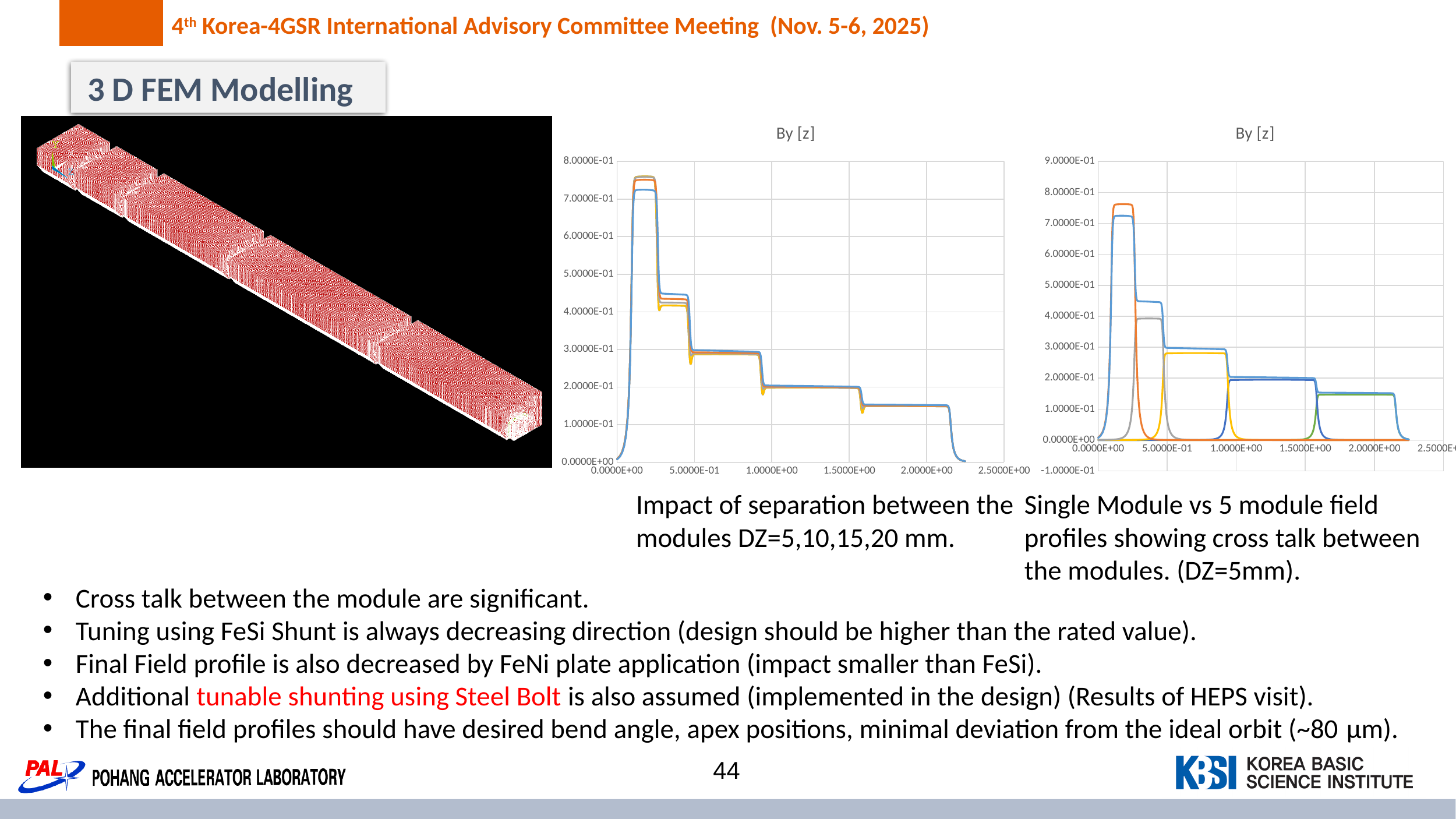
In the left chart, is the value of the last plateau near x = 2.0000E+00 greater or less than 1.0000E-01? greater In the left chart, is the peak value of the curves near x = 2.5000E-01 greater or less than 7.0000E-01? greater In the left chart, is the value of the last plateau near x = 2.0000E+00 greater or less than 2.0000E-01? less What kind of chart is the right chart titled "By [z]"? line chart In the left chart, what is the highest tick label shown on the y axis? 8.0000E-01 What kind of chart is the left chart titled "By [z]"? line chart In the right chart, what is the highest tick label shown on the y axis? 9.0000E-01 What is the title of the left chart? By [z] In the right chart, what is the lowest tick label shown on the y axis? -1.0000E-01 In the left chart, do the plotted values generally rise or fall as x increases from the first plateau to the last? fall